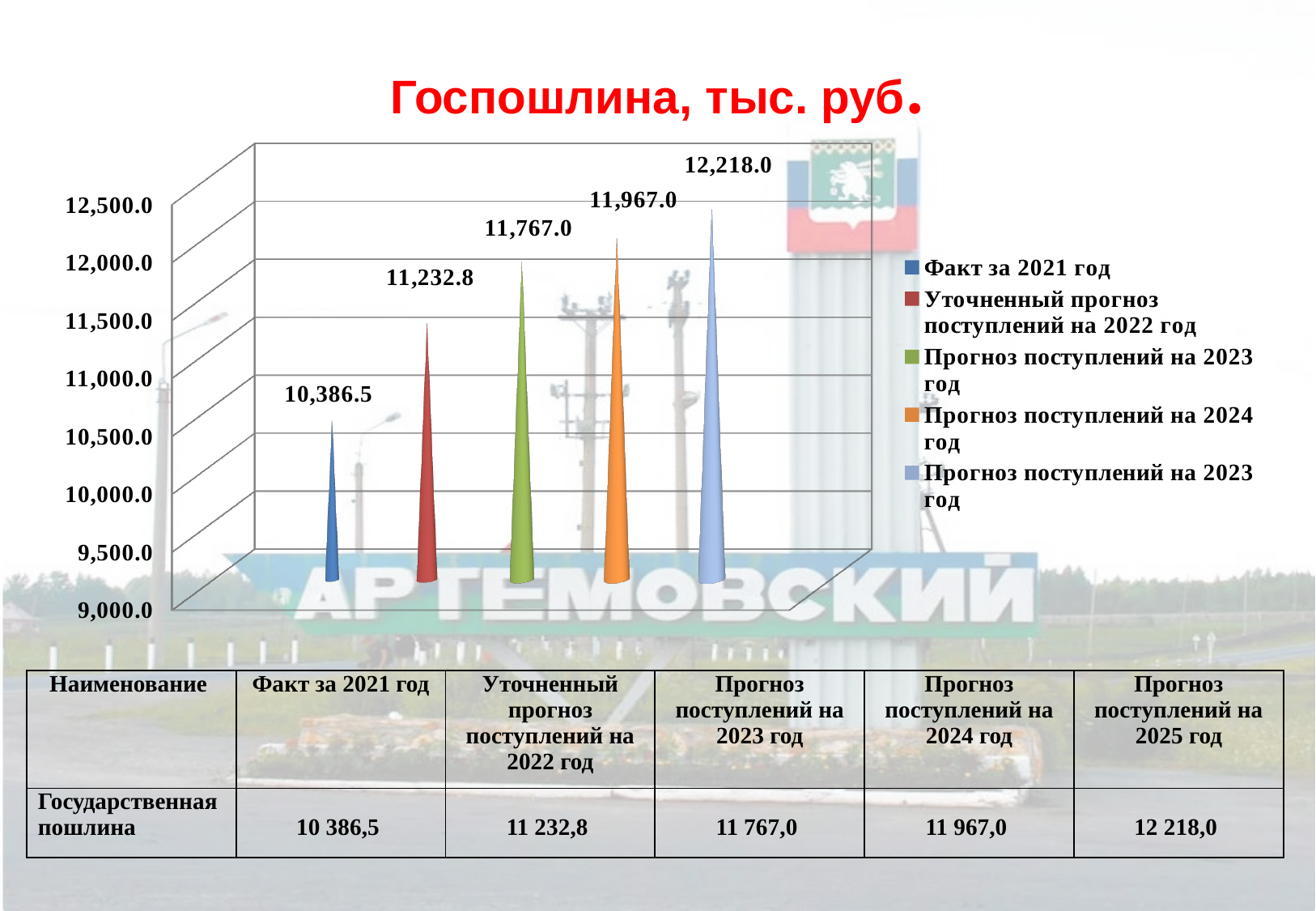
What value is shown for Прогноз поступлений на 2024 год? 11,967.0 What is the highest value shown in the chart? 12,218.0 What is the title of the chart? Госпошлина, тыс. руб. Which is larger: Уточненный прогноз поступлений на 2022 год or Прогноз поступлений на 2024 год? Прогноз поступлений на 2024 год What value is shown on the rightmost (light blue) cone? 12,218.0 What is the difference between the rightmost cone (12,218.0) and Факт за 2021 год? 1,831.5 Is the value for Факт за 2021 год greater or less than 10,500.0? less How many series does the legend list? 5 Which series has the lowest value? Факт за 2021 год What value is shown for Уточненный прогноз поступлений на 2022 год? 11,232.8 What value is shown for Факт за 2021 год? 10,386.5 Do the values rise or fall from left to right across the chart? rise